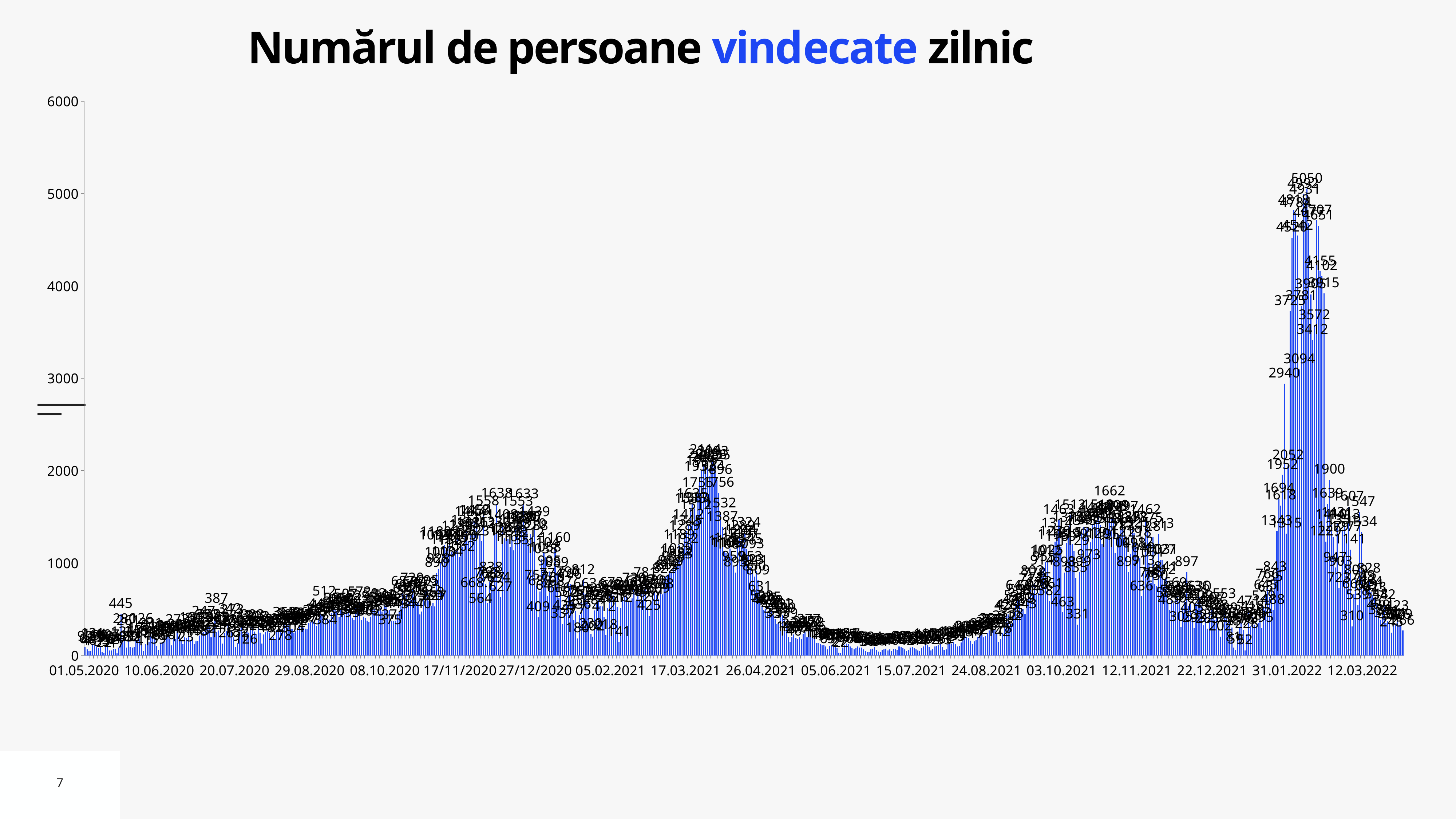
Do the values rise or fall from 01.05.2020 to 10.06.2020? rise Is the peak value around 12.11.2021 greater or less than 2000? less What is the highest value shown on the vertical axis? 6000 How many date labels are shown along the horizontal axis? 18 What is the title of the chart? Numărul de persoane vindecate zilnic What is the highest data label shown on the chart? 5050 Which period has the higher peak: around 31.01.2022 or around 17.03.2021? around 31.01.2022 Is the highest bar in the chart greater or less than 5000? greater Are the values around 15.07.2021 greater or less than 500? less What kind of chart is shown on the slide? bar chart